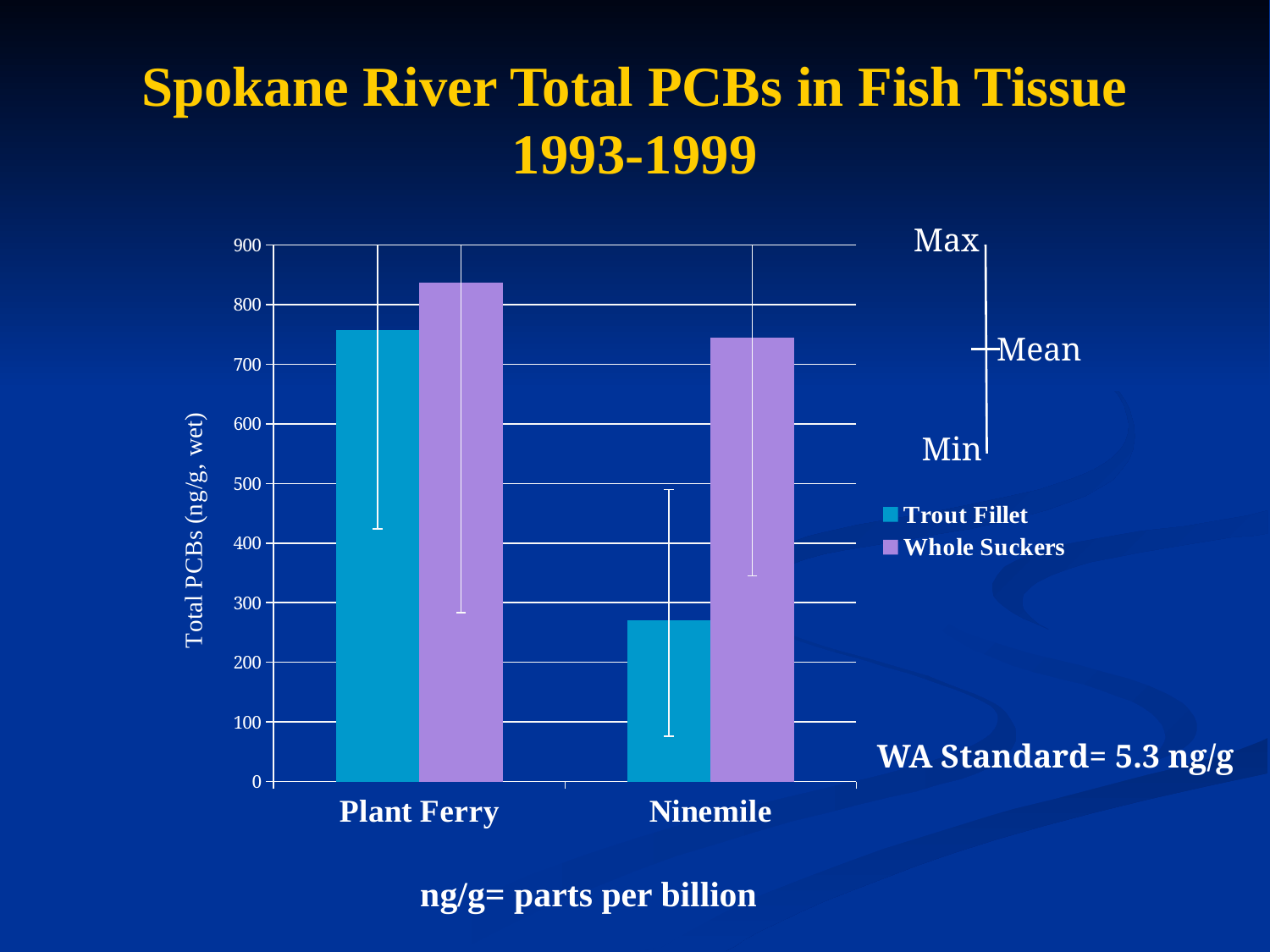
Is the Trout Fillet value at Plant Ferry greater or less than 700? greater Is the Trout Fillet value at Ninemile greater or less than 300? less Is the Whole Suckers value at Plant Ferry greater or less than 800? greater How many series does the legend list? 2 Which bar is the highest in the chart? Whole Suckers at Plant Ferry What is the WA Standard value stated on the slide? 5.3 ng/g What kind of chart is shown on the slide? Bar chart At Ninemile, which is larger: Trout Fillet or Whole Suckers? Whole Suckers How many site categories are shown on the x axis? 2 At Plant Ferry, which is larger: Trout Fillet or Whole Suckers? Whole Suckers Which bar is the lowest in the chart? Trout Fillet at Ninemile